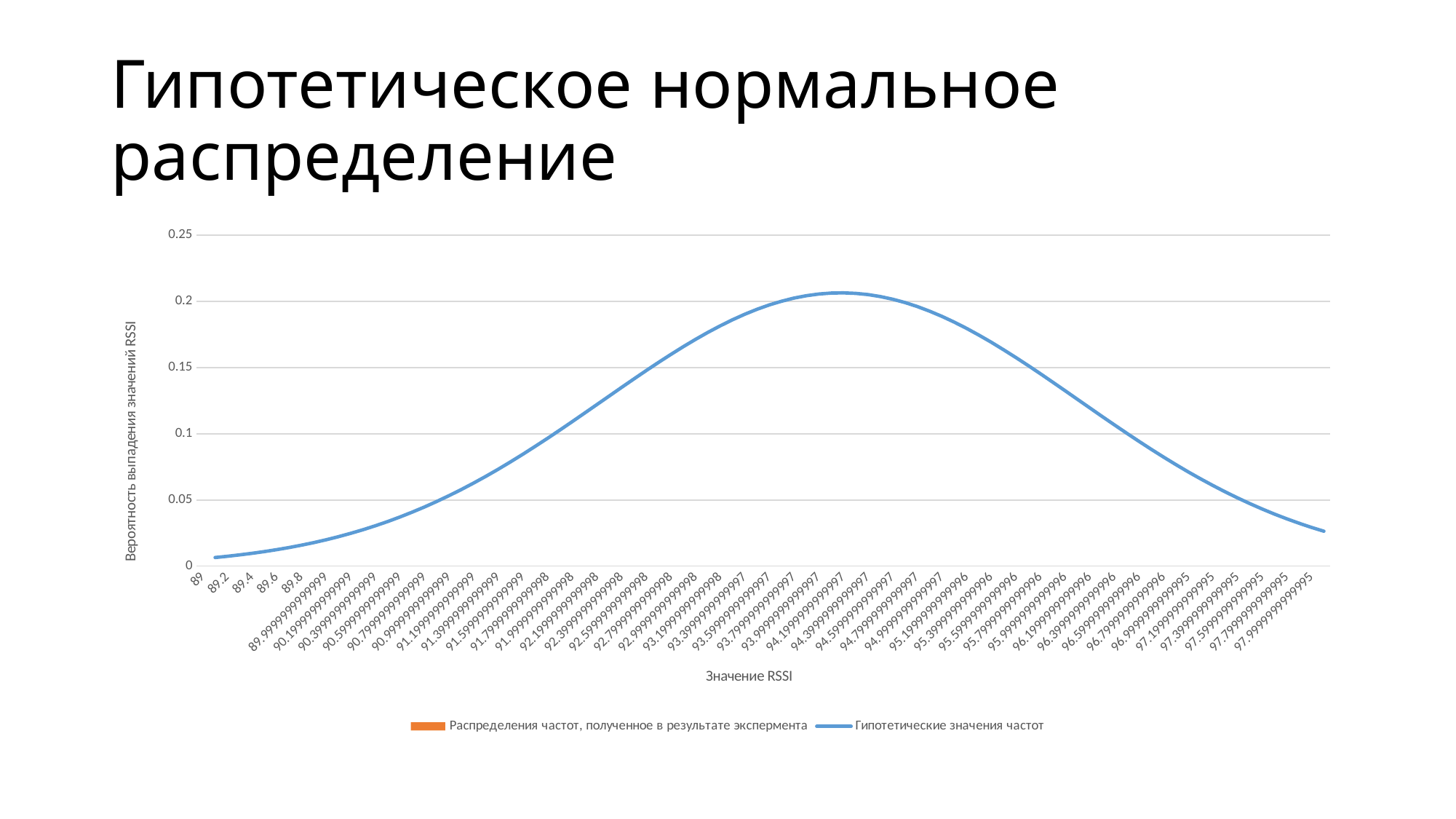
What is the title of the chart's vertical axis? Вероятность выпадения значений RSSI Is the value of the blue line at 97.9999999999995 greater or less than 0.05? less How many series does the legend list? 2 Is the value of the blue line at 89 greater or less than 0.05? less Which is larger: the value of the blue line at 89 or at 97.9999999999995? 97.9999999999995 How do the values of the blue line change along the x axis? rise to a peak, then fall Is the highest value of the blue line greater or less than 0.2? greater What kind of chart is shown on the slide? line chart What is the title of the chart's horizontal axis? Значение RSSI